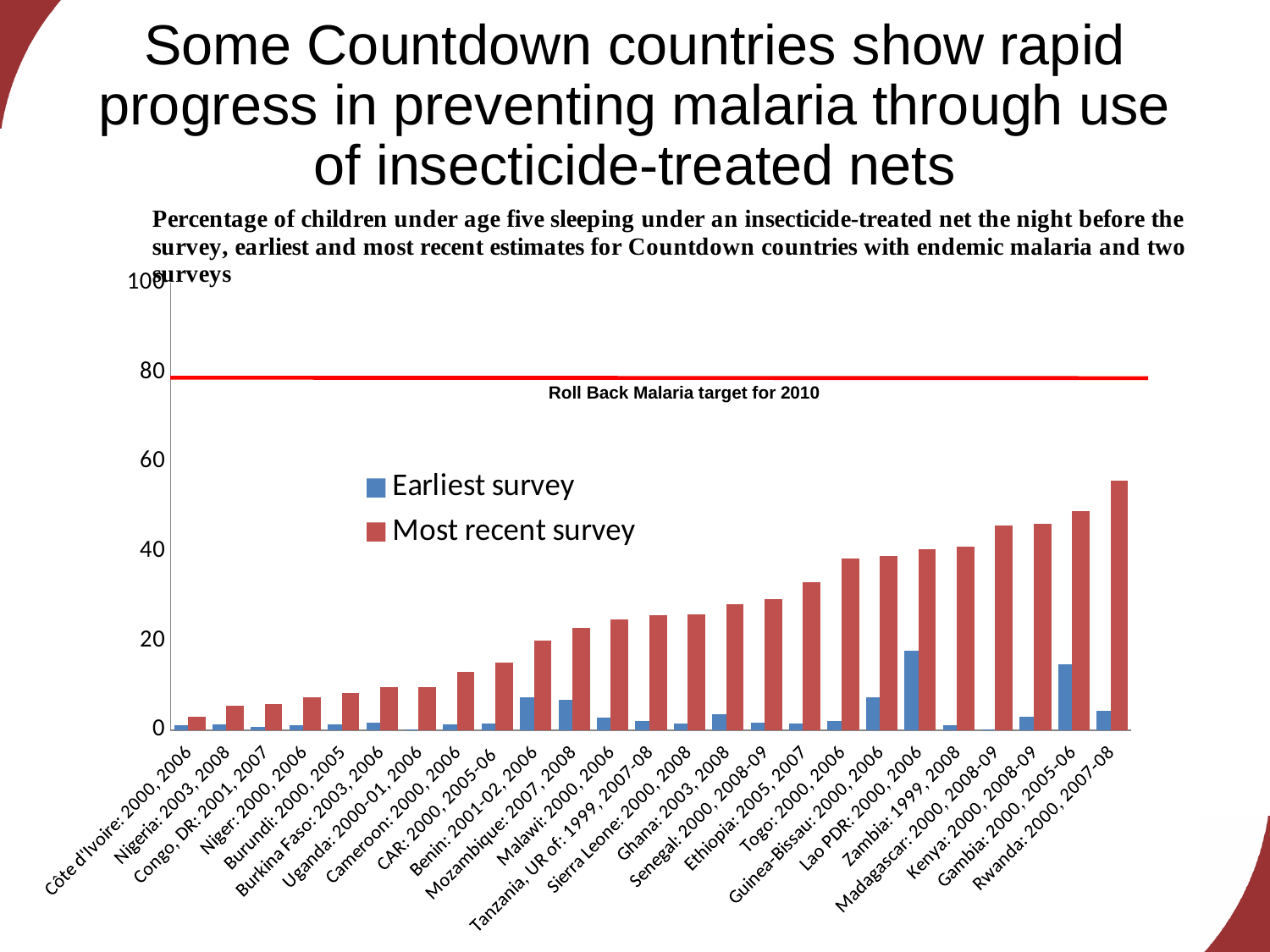
How many countries are shown on the x axis of the chart? 25 What kind of chart is shown on the slide? Bar chart Which country has the highest value for the Earliest survey? Lao PDR Which has the larger Most recent survey value, Rwanda or Gambia? Rwanda Is the Earliest survey value for Lao PDR greater or less than 10? greater What does the red horizontal line on the chart represent? Roll Back Malaria target for 2010 Do the Most recent survey values rise or fall moving from left to right along the x axis? Rise Which country has the highest value for the Most recent survey? Rwanda Is the Most recent survey value for Rwanda greater or less than 40? greater How many series does the legend list? 2 Which country has the lowest value for the Most recent survey? Côte d'Ivoire